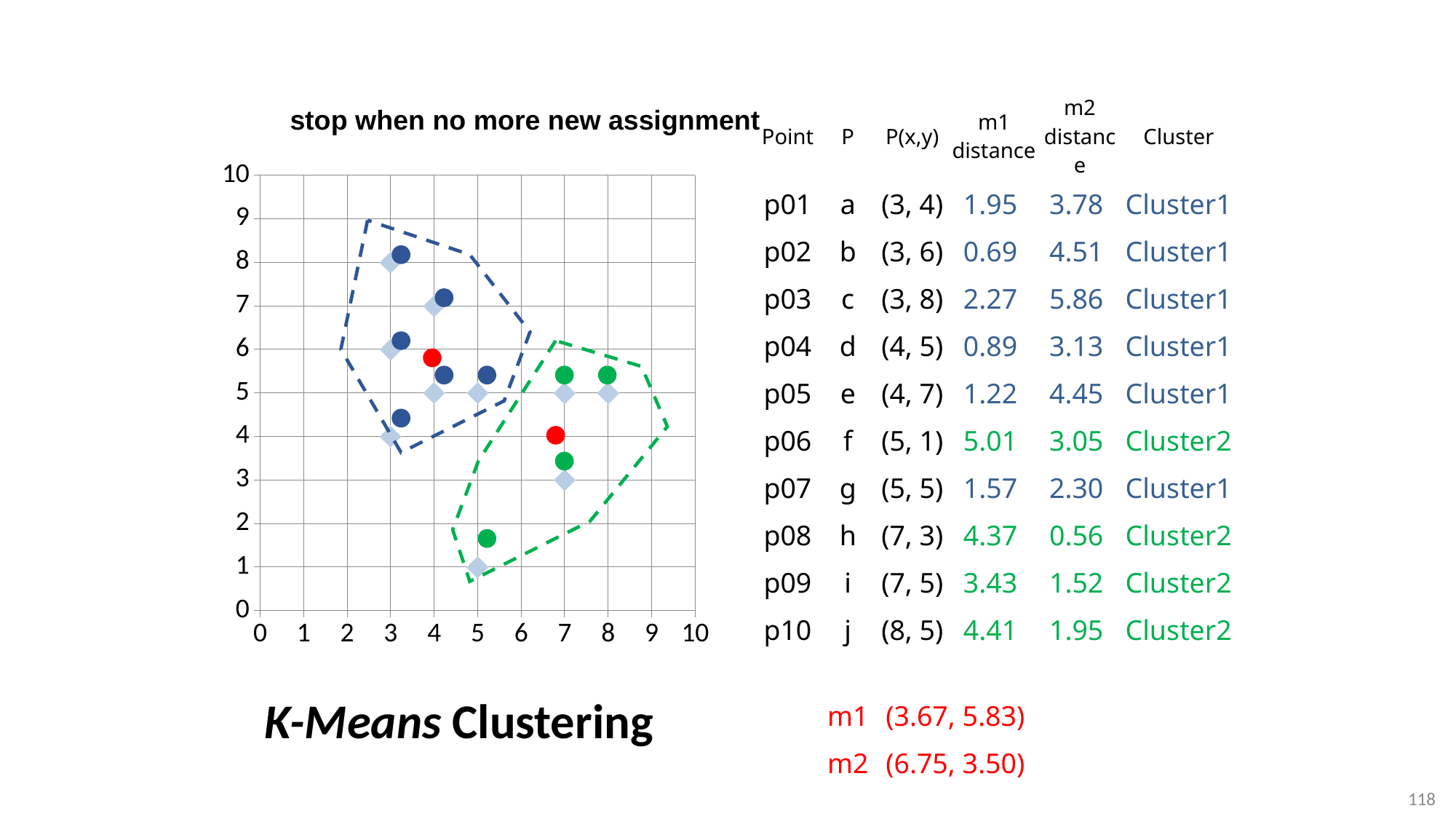
Which point has the lowest y value on the chart? f (5, 1) Is the y value of point f (5, 1) greater or less than 2? less How many red centroid points are plotted on the chart? 2 What are the coordinates of point p03 (c) on the chart? (3, 8) Which point has the highest y value on the chart? c (3, 8) What is the difference in x value between point j (8, 5) and point a (3, 4)? 5 What are the coordinates of the centroid m2? (6.75, 3.50) What kind of chart is shown on the left of the slide? scatter chart What is the maximum value shown on the x axis of the chart? 10 What are the coordinates of the centroid m1? (3.67, 5.83) Which has a larger x value, point j (8, 5) or point a (3, 4)? j (8, 5) How many light-blue diamond data points are plotted on the chart? 10